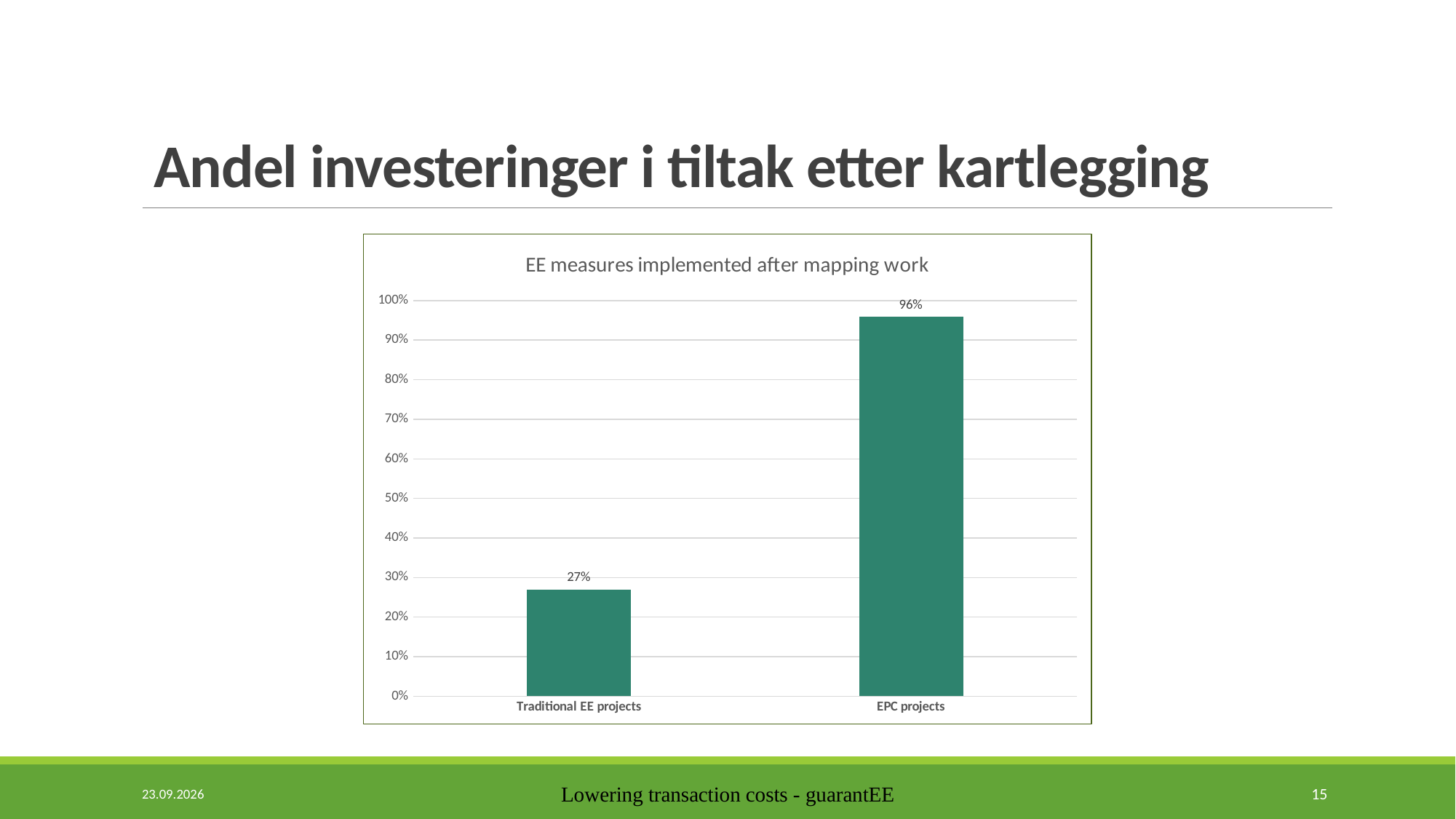
Is the value for EPC projects greater or less than 90%? greater Which is larger, the value for Traditional EE projects or the value for EPC projects? EPC projects Is the value for Traditional EE projects greater or less than 30%? less What is the value for EPC projects? 96% What is the difference between the values for EPC projects and Traditional EE projects? 69% Which category has the highest value? EPC projects What kind of chart is shown on the slide? bar chart What is the highest value shown on the vertical axis? 100% What is the title of the chart? EE measures implemented after mapping work Which category has the lowest value? Traditional EE projects What is the value for Traditional EE projects? 27% How many categories are shown on the chart? 2